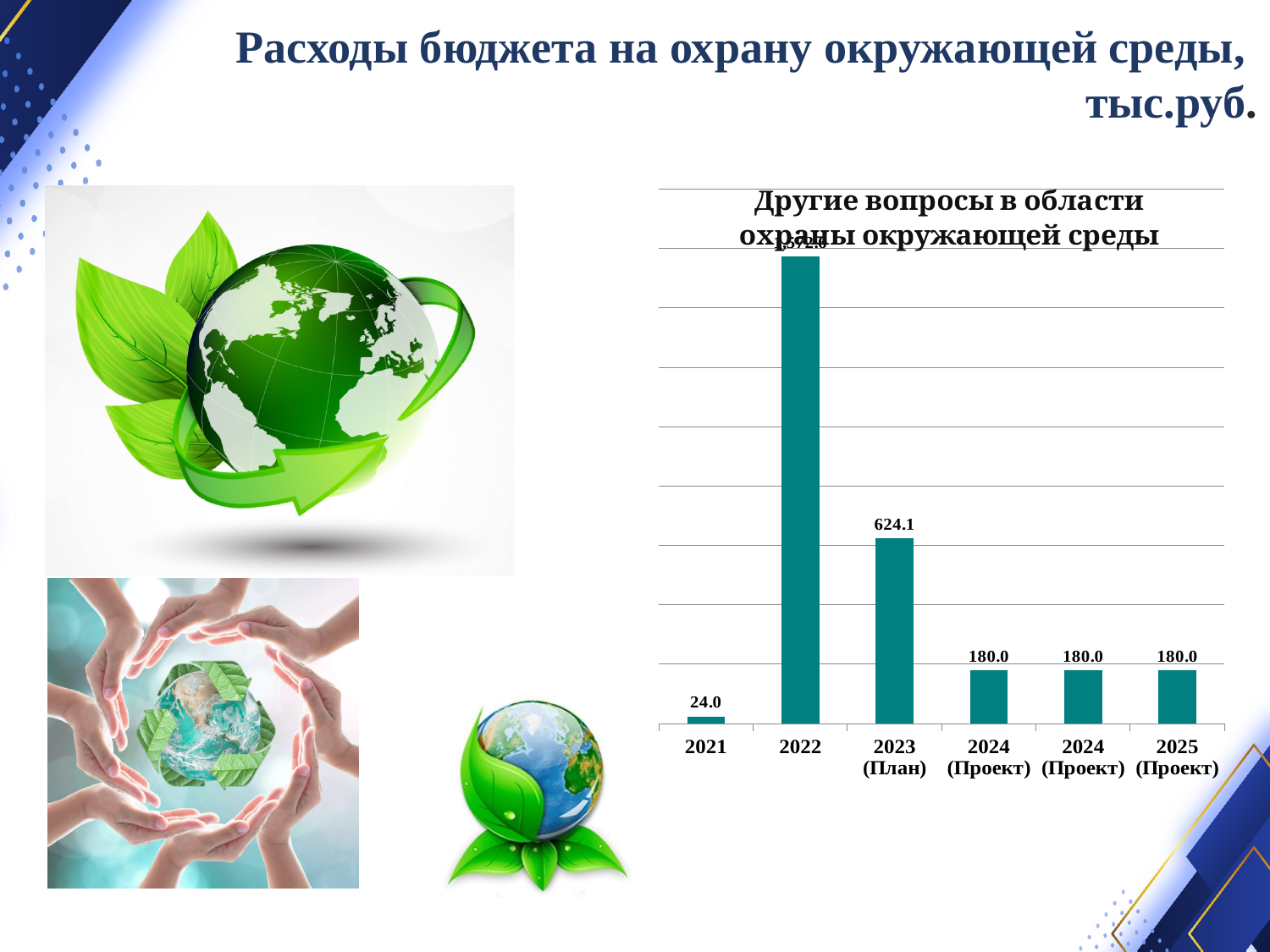
Which is larger, the value for 2021 or the value for 2025 (Проект)? 2025 (Проект) Do the values rise or fall from 2022 to 2025 (Проект)? fall What is the value for 2021? 24.0 Which year has the lowest value? 2021 What is the difference between the values for 2023 (План) and 2021? 600.1 Which year has the highest value? 2022 What is the difference between the values for 2023 (План) and 2025 (Проект)? 444.1 How many bars are plotted in the chart? 6 What is the title of the chart? Другие вопросы в области охраны окружающей среды What is the value for 2023 (План)? 624.1 What is the value for 2025 (Проект)? 180.0 What type of chart is shown on the slide? bar chart